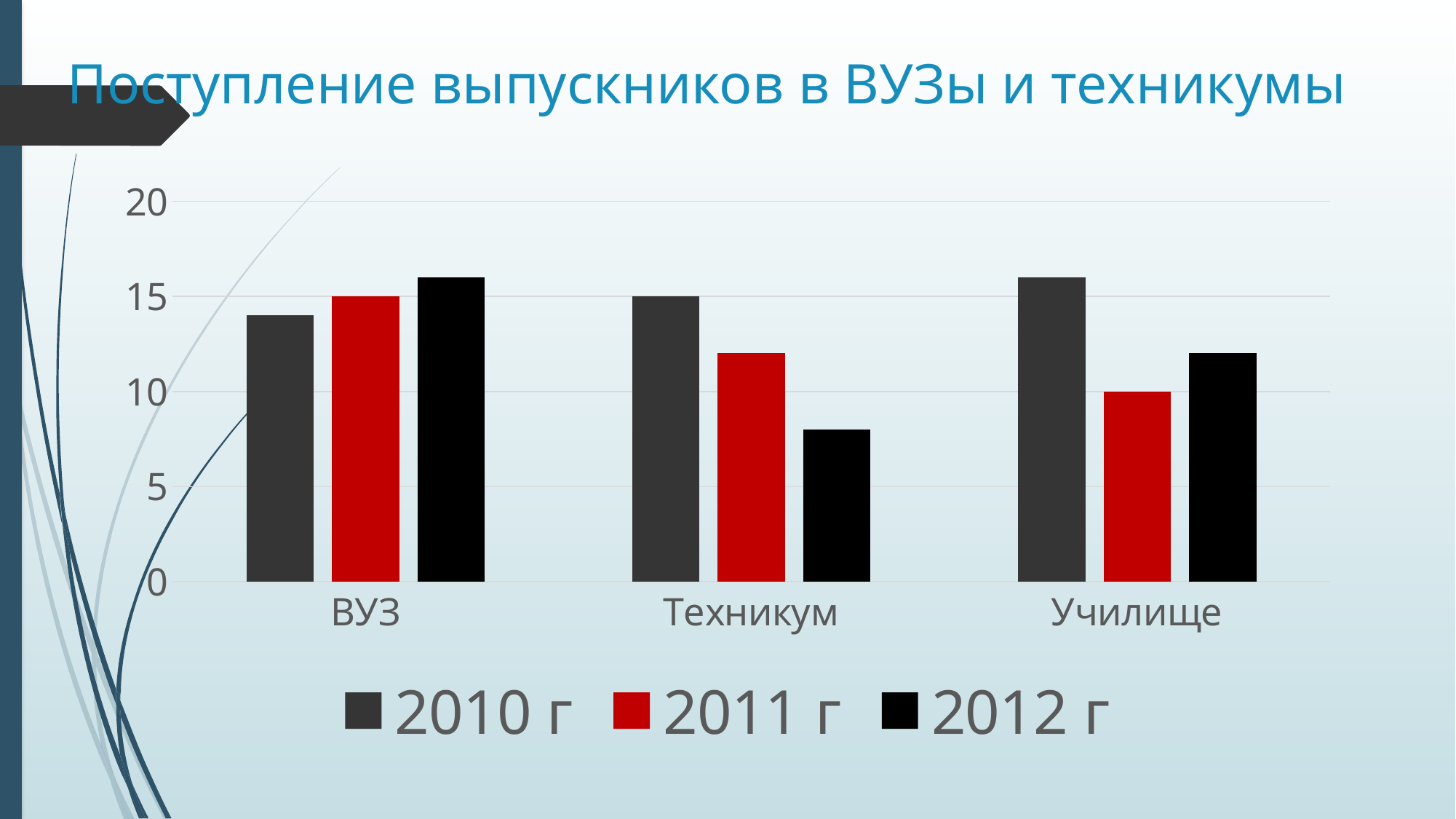
What is the value for Училище in the 2011 г series? 10 Is the value for Училище in the 2010 г series greater or less than 15? greater What is the value for ВУЗ in the 2011 г series? 15 What is the value for Техникум in the 2010 г series? 15 Which is larger in the 2011 г series: Техникум or Училище? Техникум What is the title of the chart? Поступление выпускников в ВУЗы и техникумы Which series has the lowest value for Техникум? 2012 г Which series has the highest value for Училище? 2010 г How many categories are shown on the x axis? 3 How many series does the legend list? 3 Is the value for Техникум in the 2012 г series greater or less than 10? less What type of chart is shown on the slide? bar chart